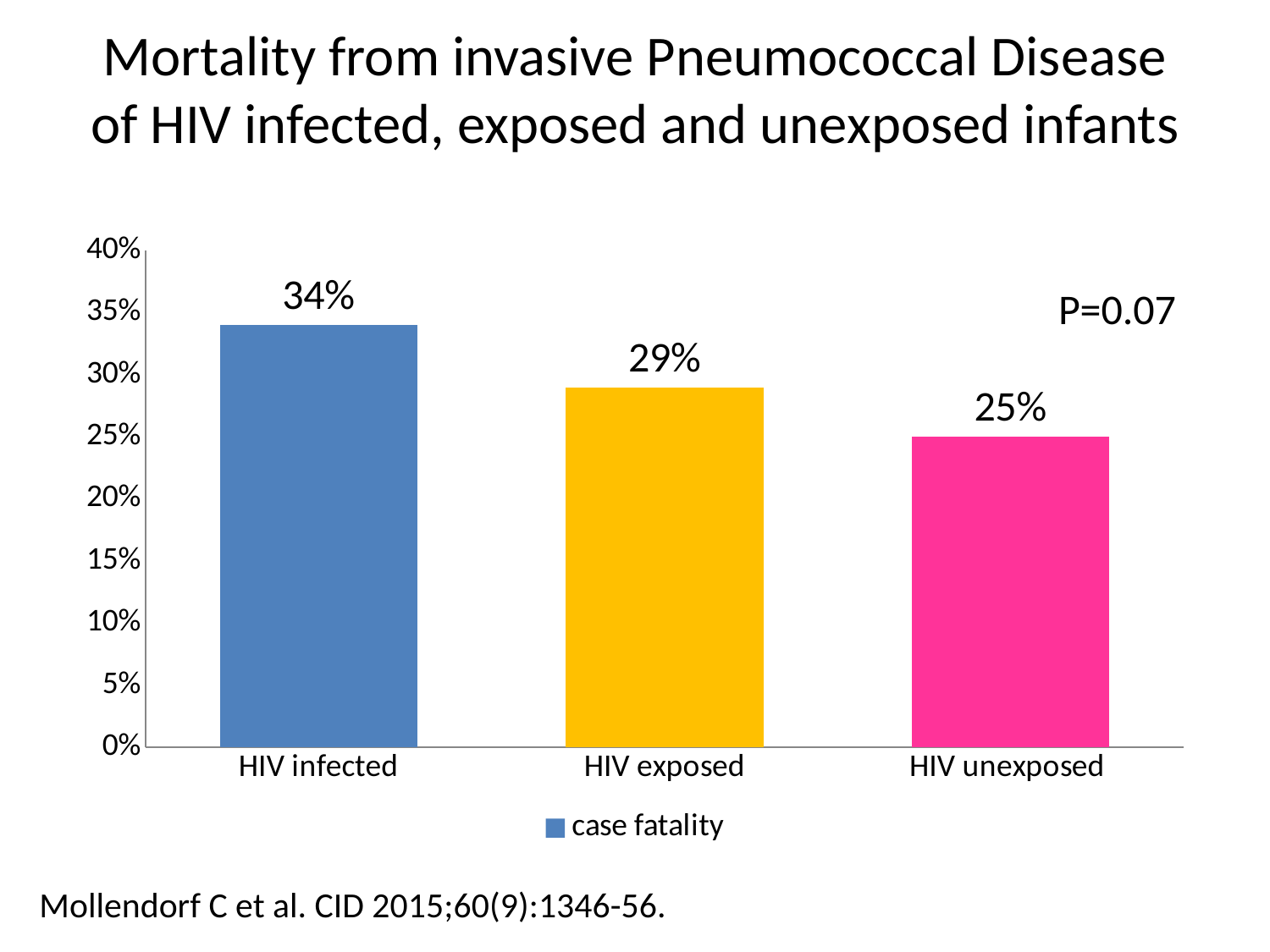
What kind of chart is shown on the slide? Bar chart Which category has the lowest case fatality? HIV unexposed What is the difference in case fatality between HIV infected and HIV exposed infants? 5% What is the difference in case fatality between HIV infected and HIV unexposed infants? 9% What is the case fatality value for HIV exposed infants? 29% What P value is printed on the chart? P=0.07 Which is larger, the case fatality for HIV exposed or HIV unexposed infants? HIV exposed Which category has the highest case fatality? HIV infected What is the case fatality value for HIV unexposed infants? 25% How many series does the legend list? 1 How many categories are shown on the x axis? 3 What is the case fatality value for HIV infected infants? 34%